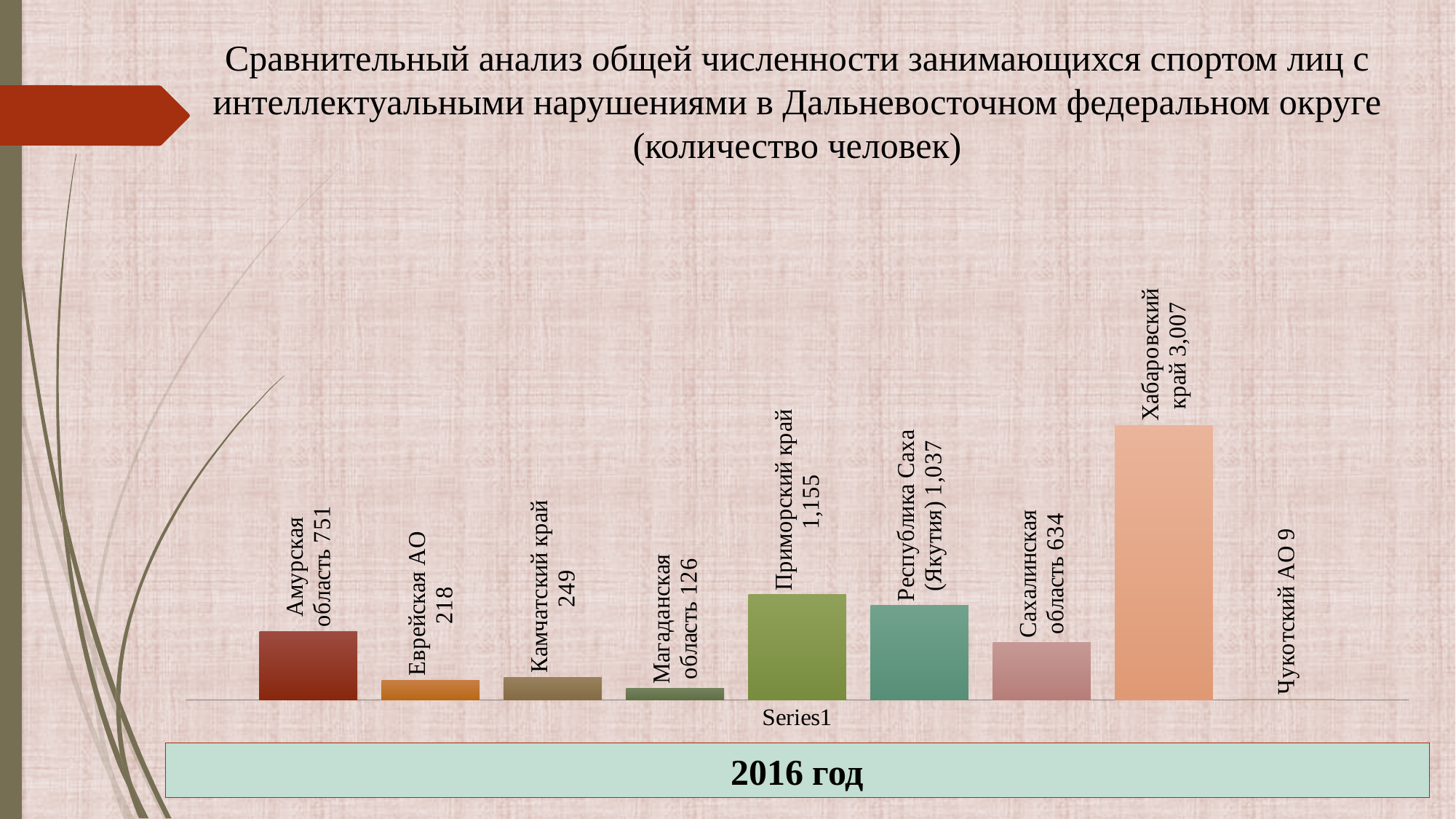
What is the value for Хабаровский край? 3,007 How many regions (bars) are plotted in the chart? 9 What is the difference between the values for Приморский край and Республика Саха (Якутия)? 118 What is the difference between the values for Камчатский край and Еврейская АО? 31 What type of chart is shown on the slide? bar chart What year is indicated in the box below the chart? 2016 год Which is larger, the value for Амурская область or the value for Сахалинская область? Амурская область What is the value for Магаданская область? 126 What is the value for Чукотский АО? 9 Which region has the lowest value in the chart? Чукотский АО What is the value for Приморский край? 1,155 Which region has the highest value in the chart? Хабаровский край